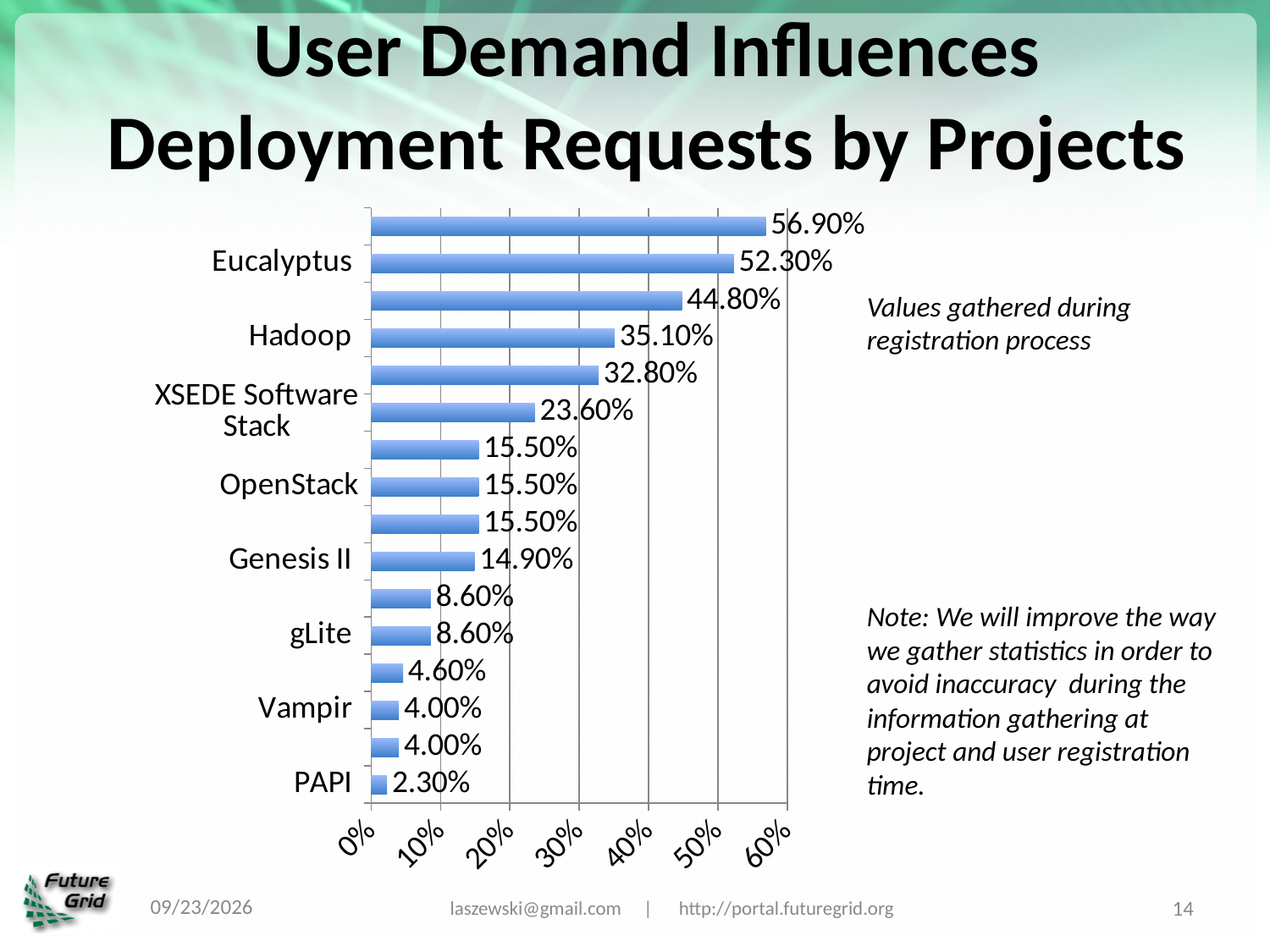
What is the value for Eucalyptus? 52.30% What is the value for XSEDE Software Stack? 23.60% Which is larger, the value for OpenStack or the value for gLite? OpenStack What is the difference between the values for Eucalyptus and Hadoop? 17.20% Which labeled category has the lowest value? PAPI What is the value for Hadoop? 35.10% What is the value for Genesis II? 14.90% What is the value for PAPI? 2.30% How many bars are plotted in the chart? 16 What is the highest value shown on the percentage axis? 60% Is the value for Vampir greater or less than 10%? less What kind of chart is shown on the slide? bar chart